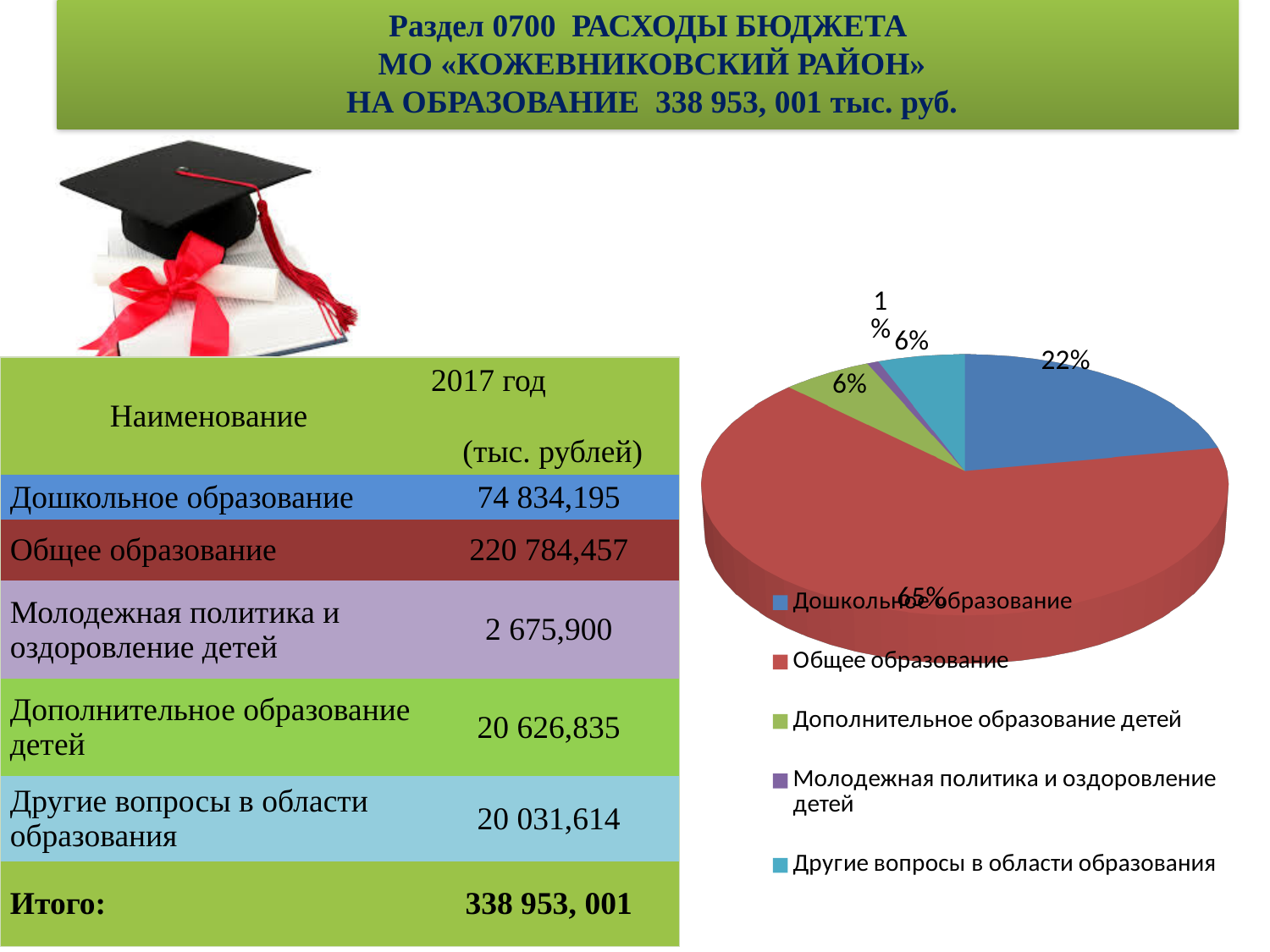
What share of the pie does Молодежная политика и оздоровление детей take? 1% Which category has the smallest slice of the pie chart? Молодежная политика и оздоровление детей What kind of chart is shown on the slide? pie chart What is the difference in percentage points between the Общее образование slice and the Дошкольное образование slice? 43 Which category has the largest slice of the pie chart? Общее образование What share of the pie does Общее образование take? 65% How many slices does the pie chart have? 5 Which slice is larger: Дошкольное образование or Дополнительное образование детей? Дошкольное образование What share of the pie does Дошкольное образование take? 22% What colour is the Общее образование slice in the pie chart? red How many entries does the pie chart's legend list? 5